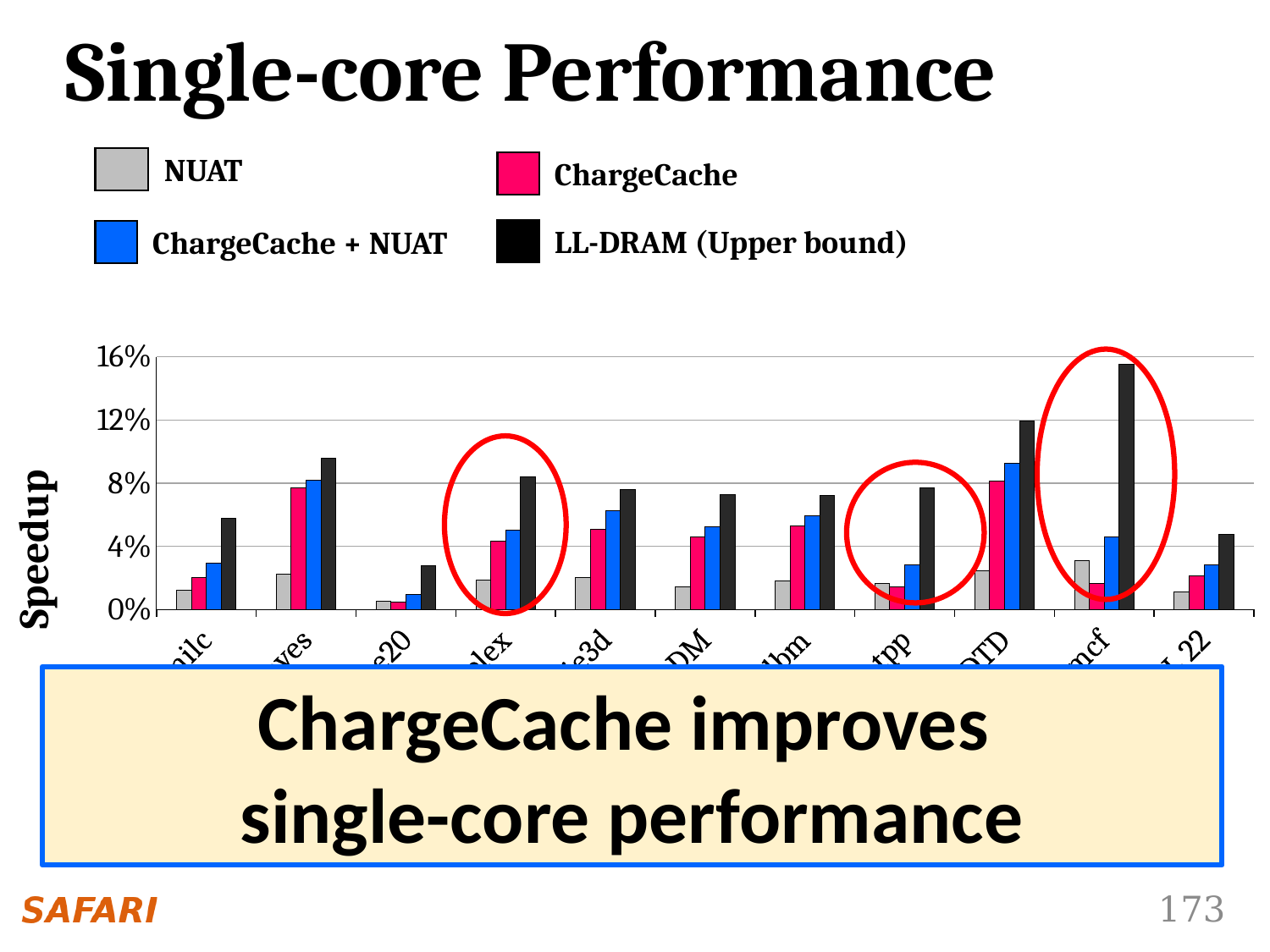
What is the label of the y axis? Speedup Is the NUAT value for milc greater or less than 4%? less Is the LL-DRAM (Upper bound) value for mcf greater or less than 12%? greater Is the ChargeCache value for mcf greater or less than 4%? less How many series does the legend list? 4 What is the highest value shown on the y axis? 16% Which category has the highest LL-DRAM (Upper bound) speedup? mcf In the second category group from the left, which is larger: the NUAT bar or the ChargeCache + NUAT bar? ChargeCache + NUAT What kind of chart is shown on the slide? bar chart How many benchmark categories are plotted along the x axis? 11 Which series has the tallest bar in every category group? LL-DRAM (Upper bound)